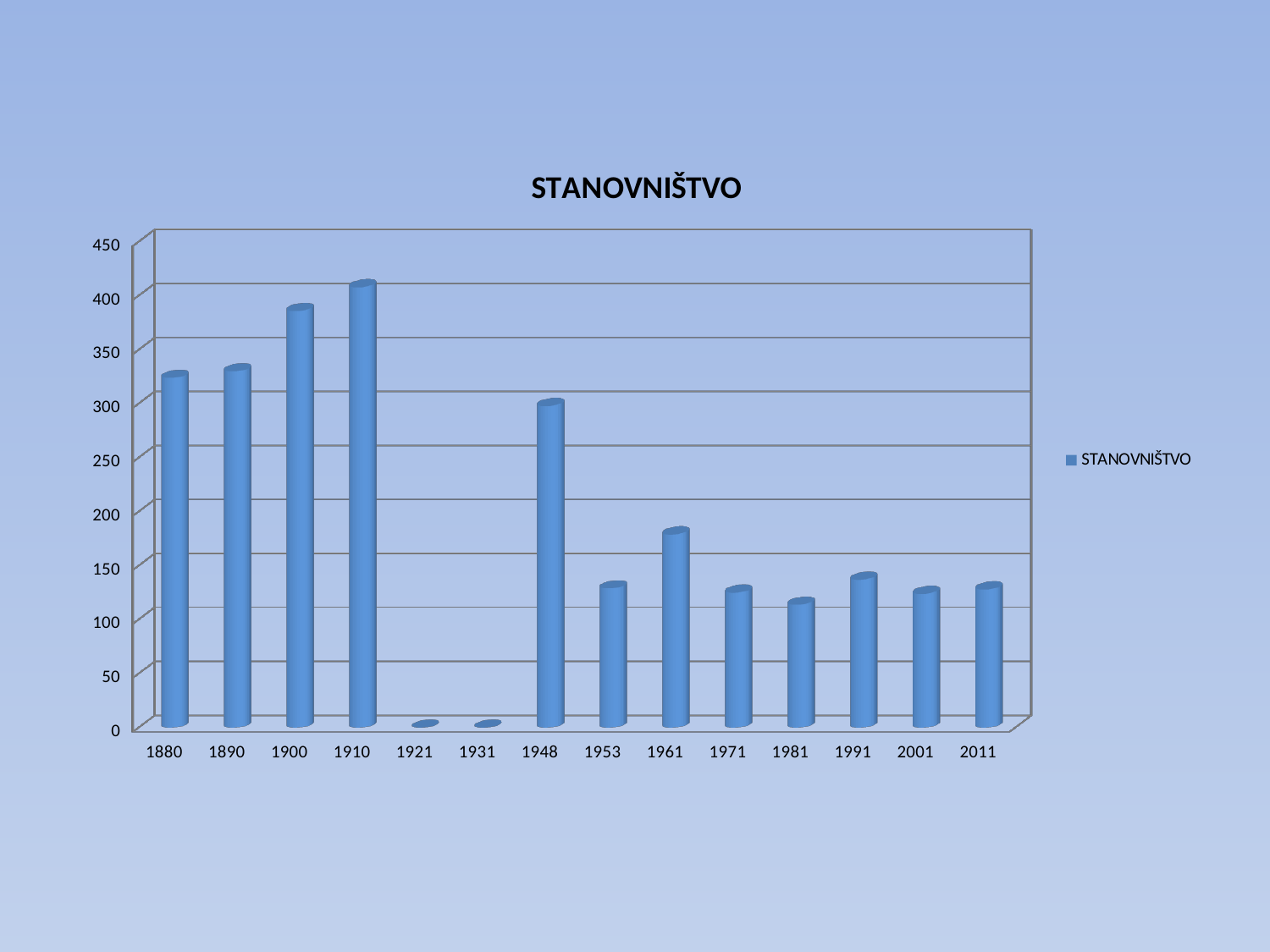
Is the value for 1981 greater or less than 150? less How many years are shown on the x axis of the chart? 14 What kind of chart is shown on the slide? bar chart Is the value for 1880 greater or less than 300? greater Which is larger, the value for 1961 or the value for 1971? 1961 Is the value for 1961 greater or less than 150? greater Which year has the highest value in the chart? 1910 Which is larger, the value for 1900 or the value for 1948? 1900 Do the values rise or fall from 1880 to 1910? rise What is the title of the chart? STANOVNIŠTVO How many series does the legend list? 1